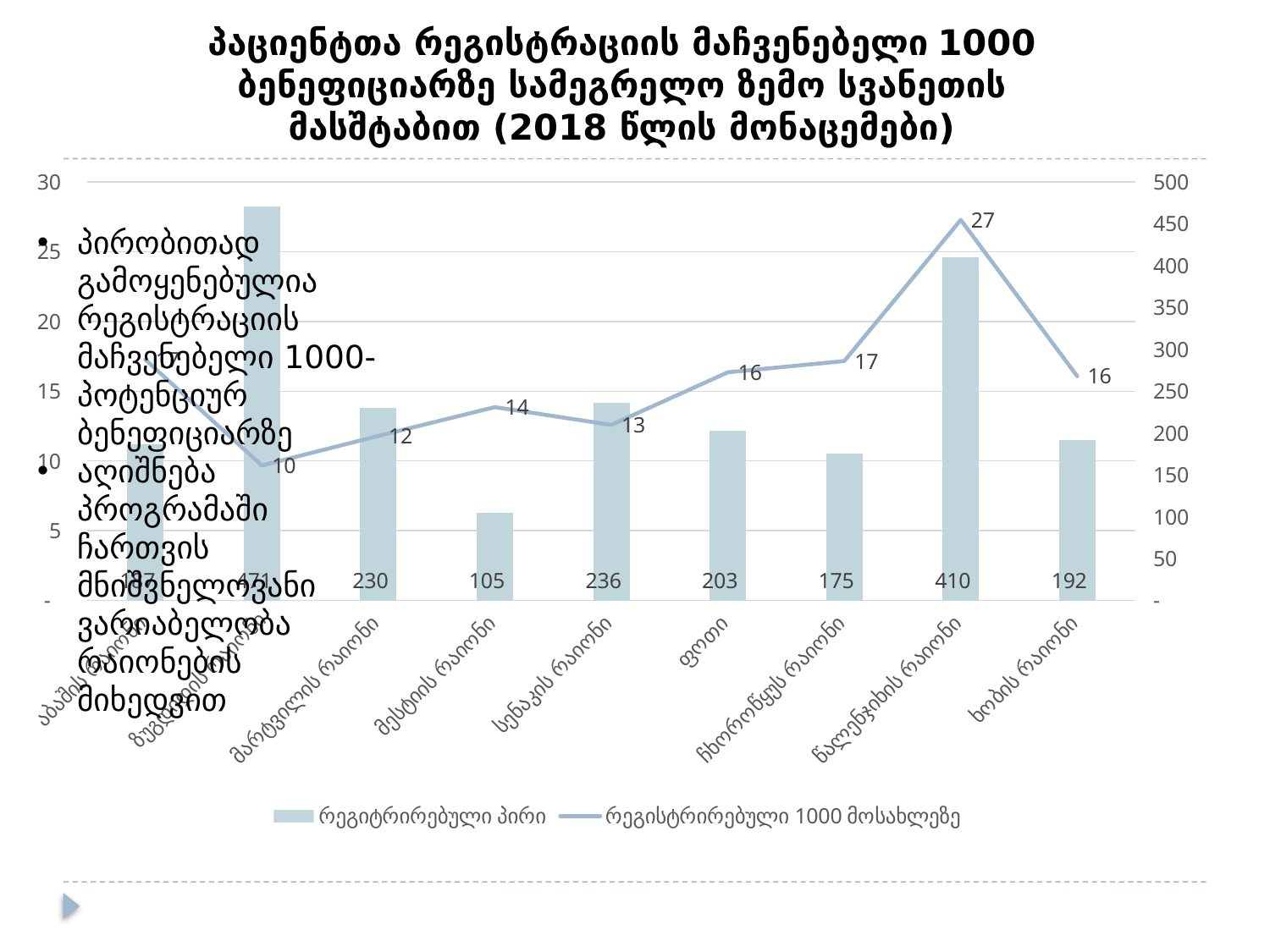
Which category has the lowest რეგიტრირებული პირი bar? მესტიის რაიონი How many series does the legend list? 2 How many categories are shown on the x axis? 9 What is the difference between the რეგიტრირებული პირი values for სენაკის რაიონი and ფოთი? 33 What is the value of the რეგიტრირებული პირი bar for ხობის რაიონი? 192 Which has a larger რეგიტრირებული პირი value, ჩხოროწყუს რაიონი or ხობის რაიონი? ხობის რაიონი What is the value of the რეგიტრირებული პირი bar for მარტვილის რაიონი? 230 What is the value of the რეგისტრირებული 1000 მოსახლეზე line for მესტიის რაიონი? 14 What is the value of the რეგისტრირებული 1000 მოსახლეზე line for ფოთი? 16 Which category has the highest value on the რეგისტრირებული 1000 მოსახლეზე line? წალენჯიხის რაიონი What kind of chart is shown on the slide? Combination bar and line chart What is the value of the რეგისტრირებული 1000 მოსახლეზე line for წალენჯიხის რაიონი? 27